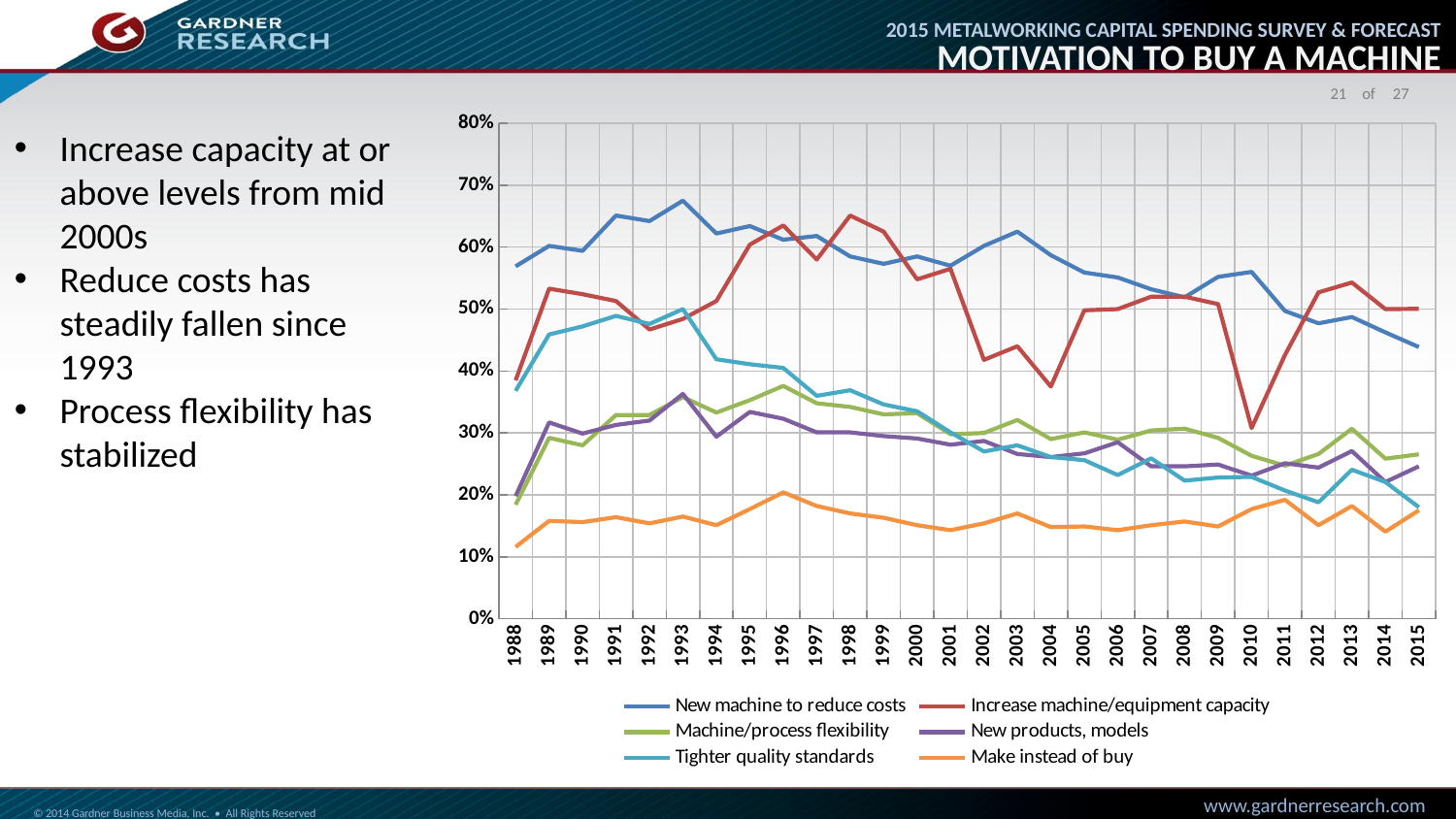
Is the value for New machine to reduce costs in 1993 greater or less than 60%? greater In 1988, which is larger: New machine to reduce costs or Increase machine/equipment capacity? New machine to reduce costs Is the value for Make instead of buy in 1988 greater or less than 10%? greater How many years are plotted along the x axis? 28 Does the New machine to reduce costs series rise or fall from 2003 to 2015? Fall Is the value for Increase machine/equipment capacity in 2010 greater or less than 40%? less What kind of chart is shown on the slide? Line chart How many series does the legend list? 6 In 2015, which is larger: New machine to reduce costs or Increase machine/equipment capacity? Increase machine/equipment capacity What is the first year shown on the x axis? 1988 Which series has the lowest values across the whole period? Make instead of buy